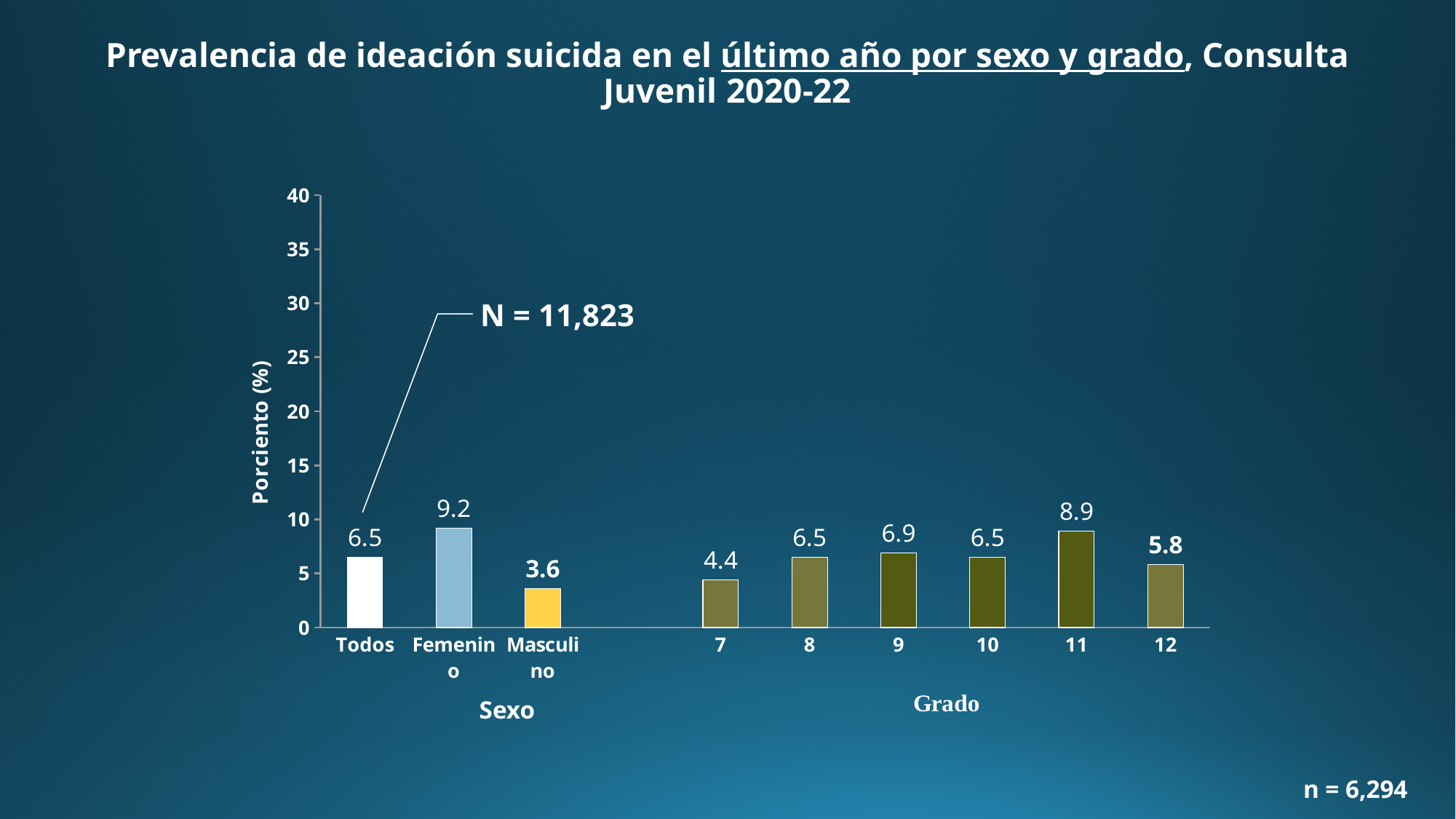
What is the value for Femenino? 9.2 What kind of chart is shown on the slide? bar chart Which category has the lowest value on the chart? Masculino What is the label of the vertical axis? Porciento (%) Which category has the highest value on the chart? Femenino Is the value for grade 11 greater or less than 10? less Which is larger, the value for grade 9 or the value for grade 12? grade 9 How many bars are plotted on the chart? 9 What is the difference between the values for Femenino and Masculino? 5.6 What is the value for Masculino? 3.6 What is the value for grade 7? 4.4 What is the value for grade 11? 8.9